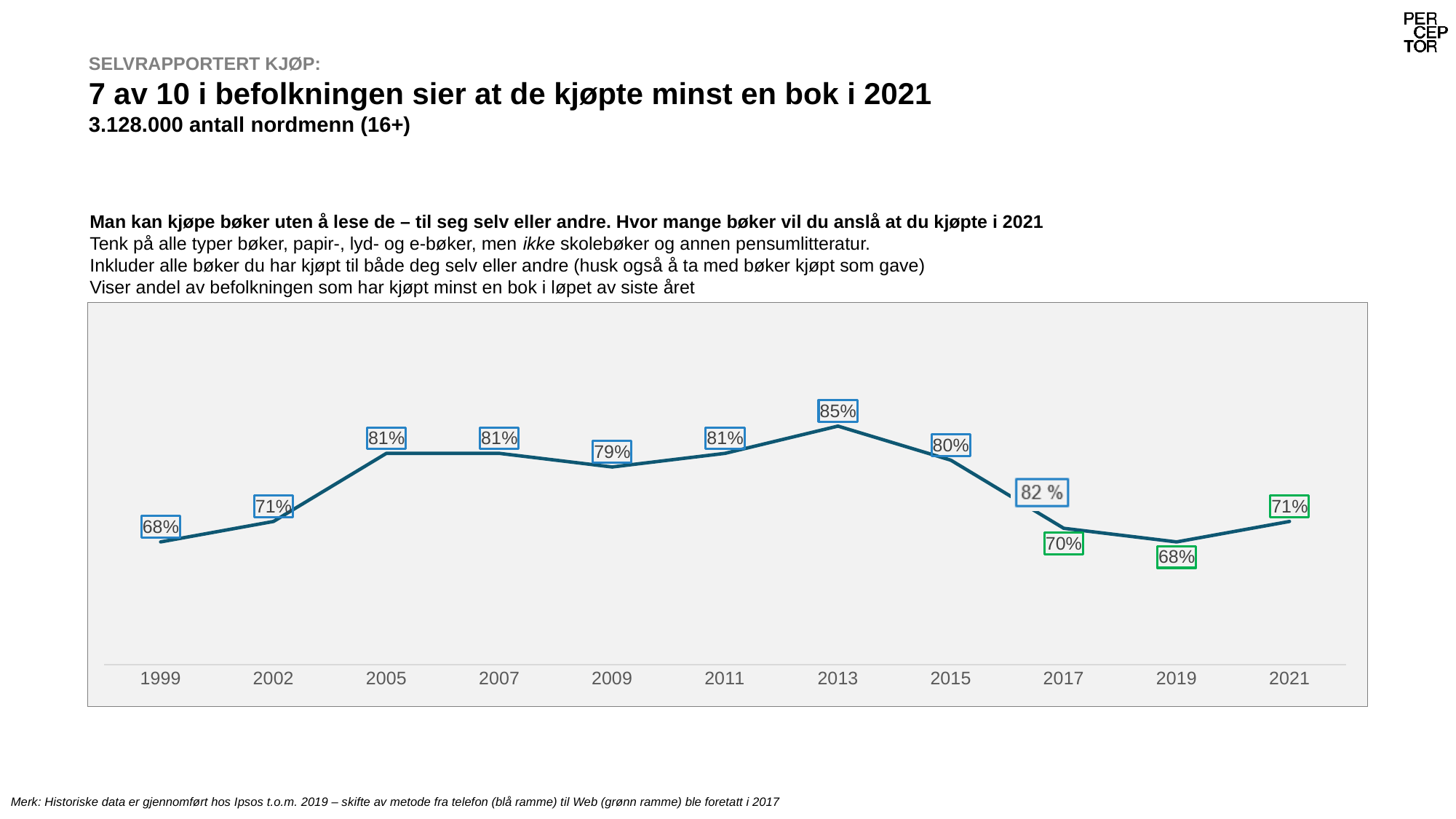
Which is larger, the value for 2011 or the value for 2019? 2011 What kind of chart is shown on the slide? line chart What is the value for 1999? 68% What is the difference between the values for 2005 and 2002? 10 percentage points What is the value for 2013? 85% Which year has the highest value? 2013 What is the value for 2015? 80% Does the value rise or fall from 2019 to 2021? rise What is the difference between the values for 2013 and 2021? 14 percentage points What is the value for 2009? 79% How many years are shown on the x axis? 11 What is the value for 2021? 71%